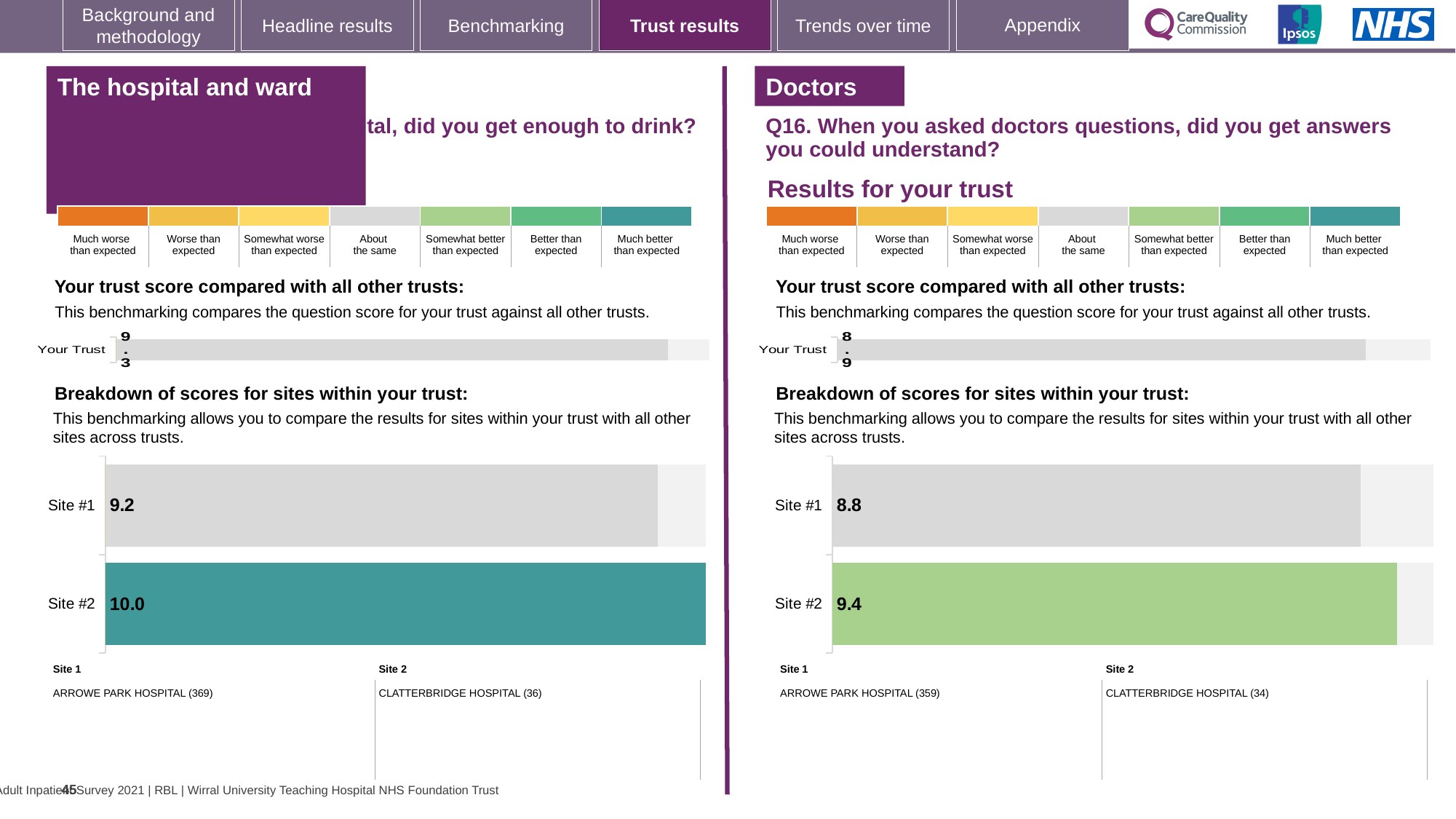
In the Q16 (Doctors) 'Your Trust' bar on the right, what is the trust score shown? 8.9 In the Q16 (Doctors) site breakdown chart on the right, what is the score for Site #2? 9.4 In the site breakdown chart on the left side of the slide, what is the score for Site #1? 9.2 In the site breakdown chart on the left side of the slide, what is the score for Site #2? 10.0 In the 'Your Trust' bar on the left side of the slide, what is the trust score shown? 9.3 How many sites are shown in the Q16 (Doctors) site breakdown chart on the right? 2 In the site breakdown chart on the left side of the slide, what is the difference between the Site #2 and Site #1 scores? 0.8 In the Q16 (Doctors) site breakdown chart on the right, what is the difference between the Site #2 and Site #1 scores? 0.6 In the Q16 (Doctors) site breakdown chart on the right, which site has the lower score? Site #1 In the Q16 (Doctors) site breakdown chart on the right, what is the score for Site #1? 8.8 In the site breakdown chart on the left side of the slide, which site has the higher score? Site #2 What type of chart is used for the site breakdown on the left side of the slide? Bar chart